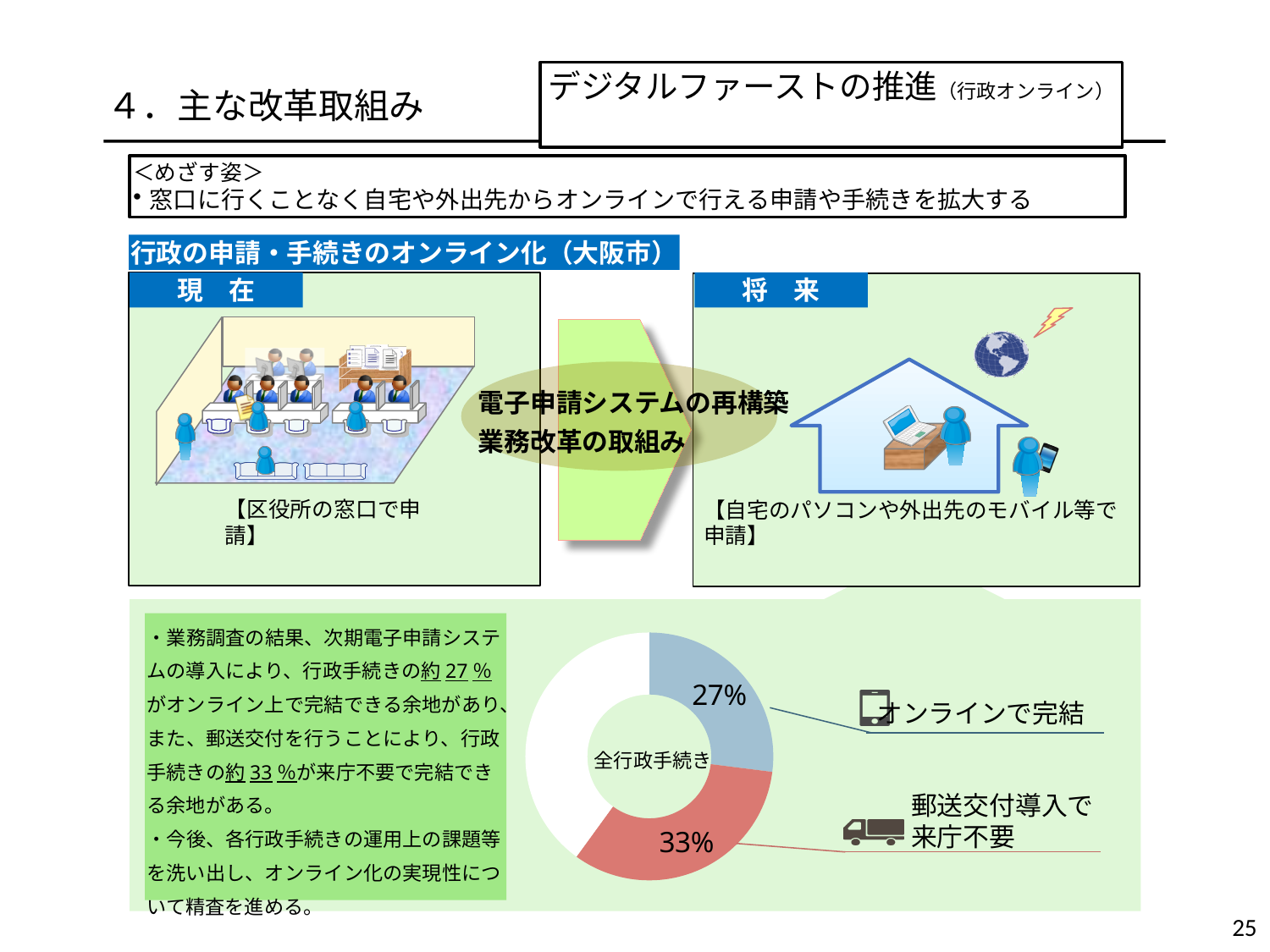
What percentage of the pie chart is labelled for オンラインで完結? 27% What percentage of the pie chart is labelled for 郵送交付導入で来庁不要? 33% What text is written in the centre of the donut chart? 全行政手続き What is the difference in percentage points between the 33% slice and the 27% slice in the pie chart? 6 percentage points Is the value for the 郵送交付導入で来庁不要 slice greater or less than 30%? greater Which is larger in the pie chart: the share for オンラインで完結 or the share for 郵送交付導入で来庁不要? 郵送交付導入で来庁不要 Is the value for the オンラインで完結 slice greater or less than 30%? less What colour is the 27% slice of the pie chart? Blue What kind of chart is shown at the bottom of the slide? Pie (donut) chart How many slices in the pie chart have a percentage label printed on them? 2